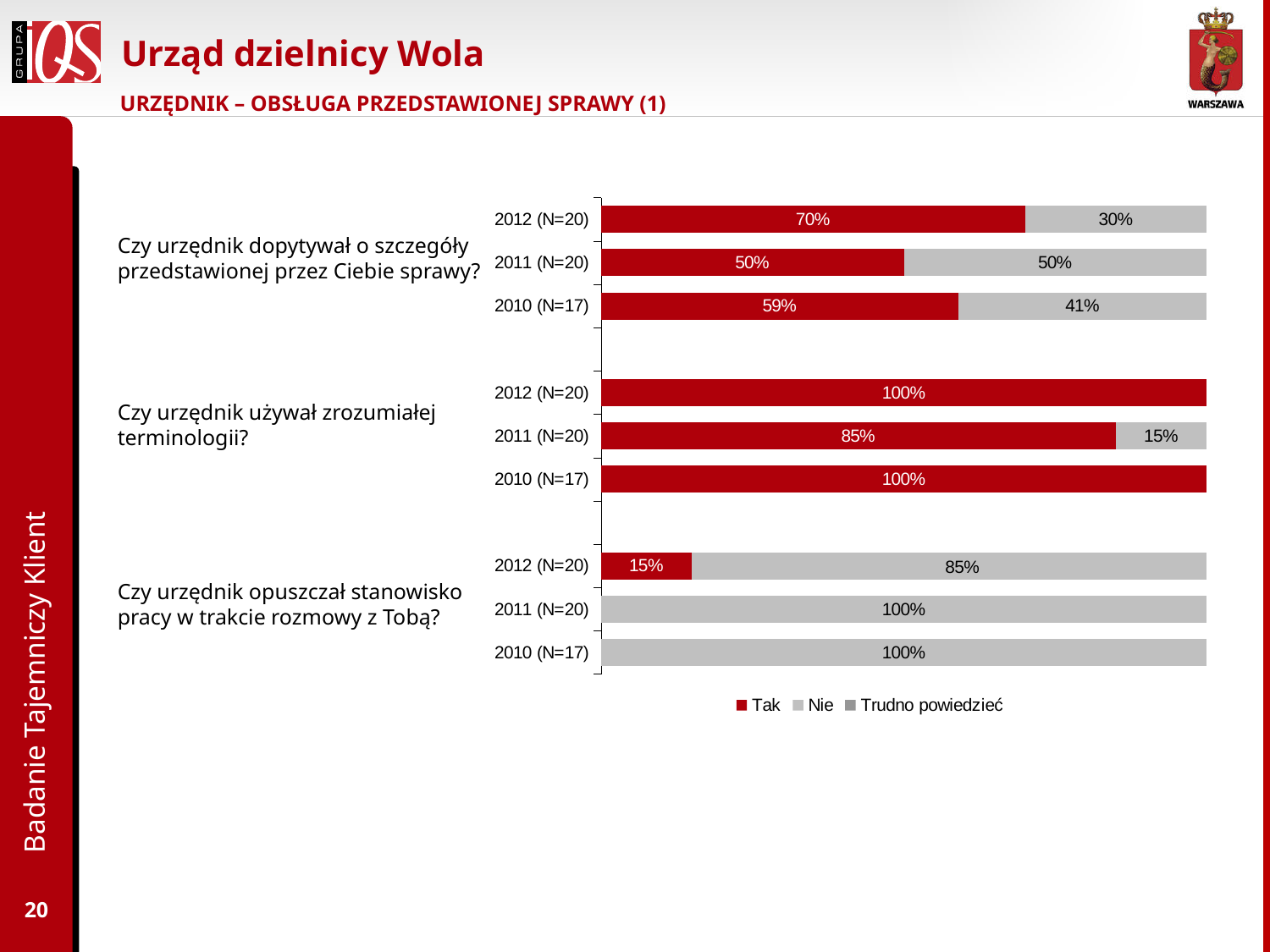
What percentage answered "Nie" in 2010 (N=17) for the question "Czy urzędnik dopytywał o szczegóły przedstawionej przez Ciebie sprawy?"? 41% How many series does the legend list? 3 For the question "Czy urzędnik dopytywał o szczegóły przedstawionej przez Ciebie sprawy?", which year has the lowest "Tak" share? 2011 (N=20) For the question "Czy urzędnik używał zrozumiałej terminologii?", is the "Tak" share larger in 2012 (N=20) or in 2011 (N=20)? 2012 (N=20) What is the total of the stacked bar for 2011 (N=20) for the question "Czy urzędnik używał zrozumiałej terminologii?"? 100% What percentage answered "Tak" in 2011 (N=20) for the question "Czy urzędnik używał zrozumiałej terminologii?"? 85% What is the difference between the "Tak" share in 2012 (N=20) and in 2011 (N=20) for the question "Czy urzędnik dopytywał o szczegóły przedstawionej przez Ciebie sprawy?"? 20% What percentage answered "Nie" in 2012 (N=20) for the question "Czy urzędnik opuszczał stanowisko pracy w trakcie rozmowy z Tobą?"? 85% What percentage answered "Tak" in 2012 (N=20) for the question "Czy urzędnik dopytywał o szczegóły przedstawionej przez Ciebie sprawy?"? 70% For the question "Czy urzędnik dopytywał o szczegóły przedstawionej przez Ciebie sprawy?", which year has the highest "Tak" share? 2012 (N=20) Which legend entry is shown in red? Tak What kind of chart is shown on the slide? Stacked bar chart